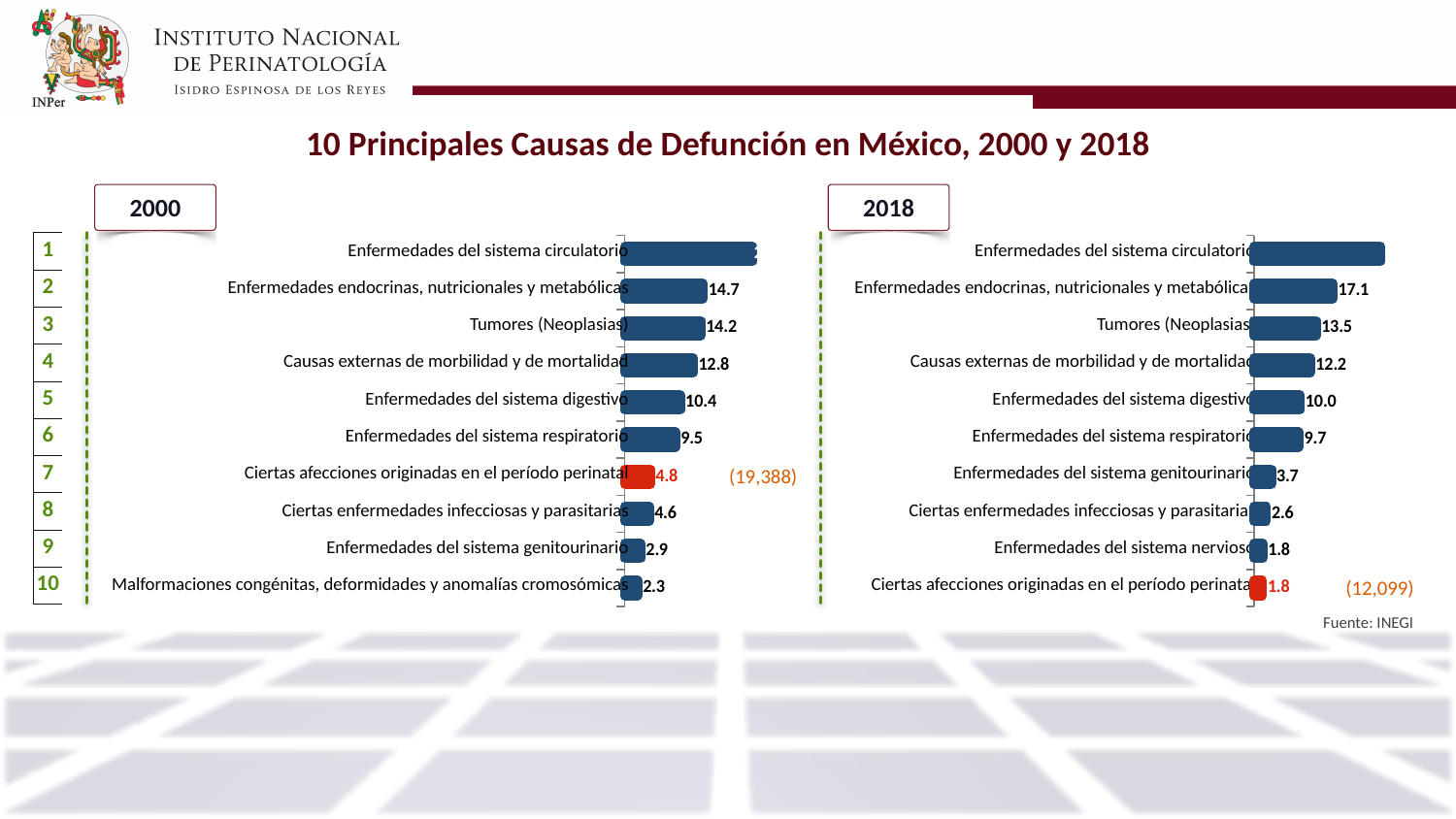
In the 2018 chart, what is the value for Tumores (Neoplasias)? 13.5 What type of chart is used for the 2000 data? Bar chart What is the difference between the 2018 value for Enfermedades endocrinas, nutricionales y metabólicas (17.1) and the 2000 value for the same cause (14.7)? 2.4 How many causes are listed in the 2018 chart? 10 In the 2018 chart, what is the value for Enfermedades del sistema genitourinario? 3.7 In the 2018 chart, what is the difference between Enfermedades del sistema digestivo (10.0) and Enfermedades del sistema respiratorio (9.7)? 0.3 In the 2018 chart, which bar is coloured red instead of blue? Ciertas afecciones originadas en el período perinatal In the 2000 chart, what is the value for Enfermedades endocrinas, nutricionales y metabólicas? 14.7 In the 2000 chart, which is larger: Enfermedades del sistema digestivo or Enfermedades del sistema respiratorio? Enfermedades del sistema digestivo In the 2018 chart, which cause has the highest value? Enfermedades del sistema circulatorio In the 2000 chart, which cause has the lowest value? Malformaciones congénitas, deformidades y anomalías cromosómicas In the 2000 chart, what is the value for Ciertas afecciones originadas en el período perinatal? 4.8